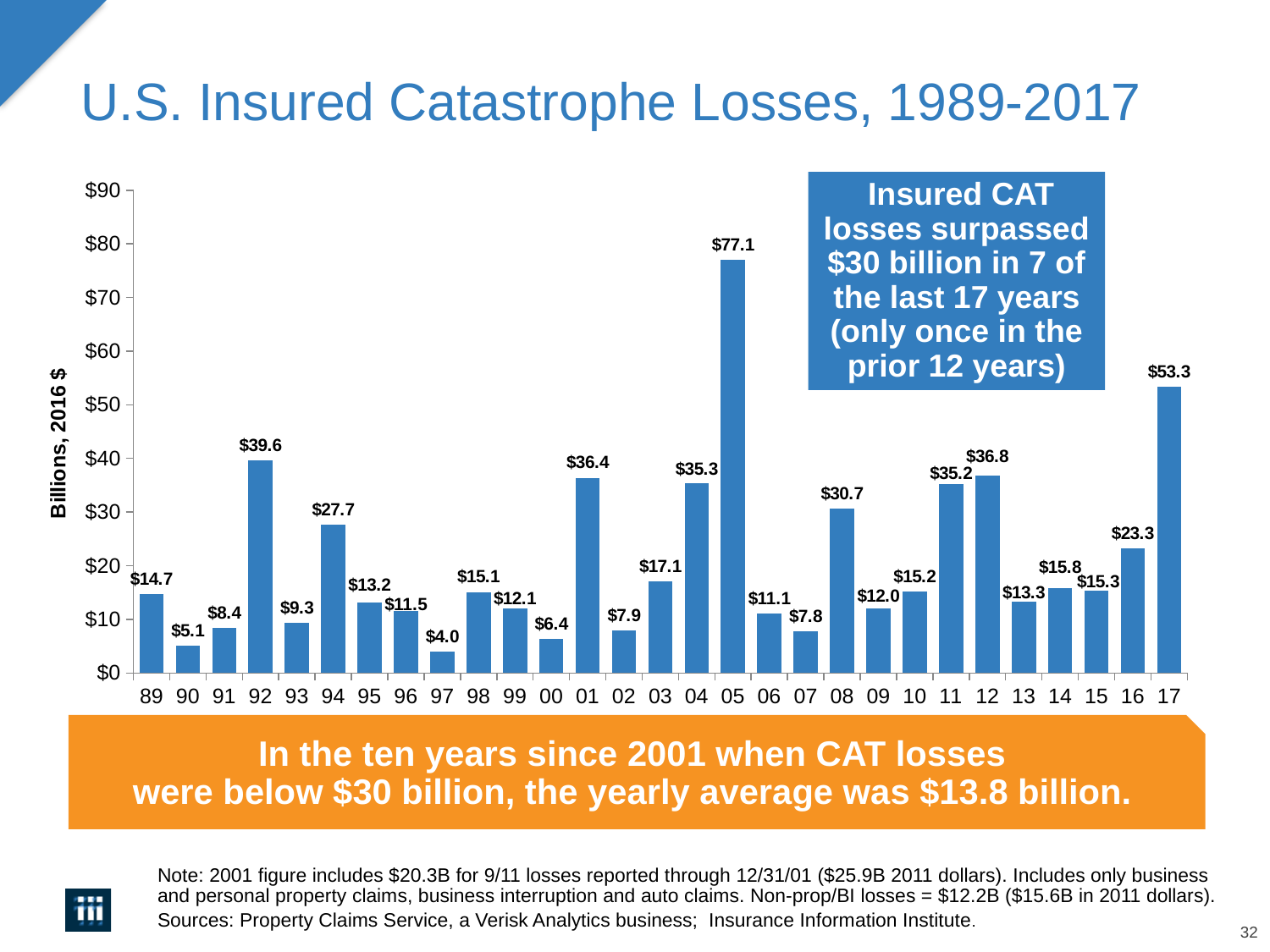
What is the label of the vertical axis? Billions, 2016 $ Is the value for 2008 greater or less than $30? greater Which is larger, the value for 2011 or the value for 2012? 2012 What is the value of U.S. insured catastrophe losses for 2005? $77.1 What kind of chart is shown on the slide? Bar chart Which year has the highest insured catastrophe losses? 2005 What is the value shown for 1992? $39.6 How many years are plotted on the chart? 29 What is the value shown for 2017? $53.3 What is the title of the chart? U.S. Insured Catastrophe Losses, 1989-2017 Which year has the lowest insured catastrophe losses? 1997 What is the difference between the 2005 value and the 2017 value? $23.8